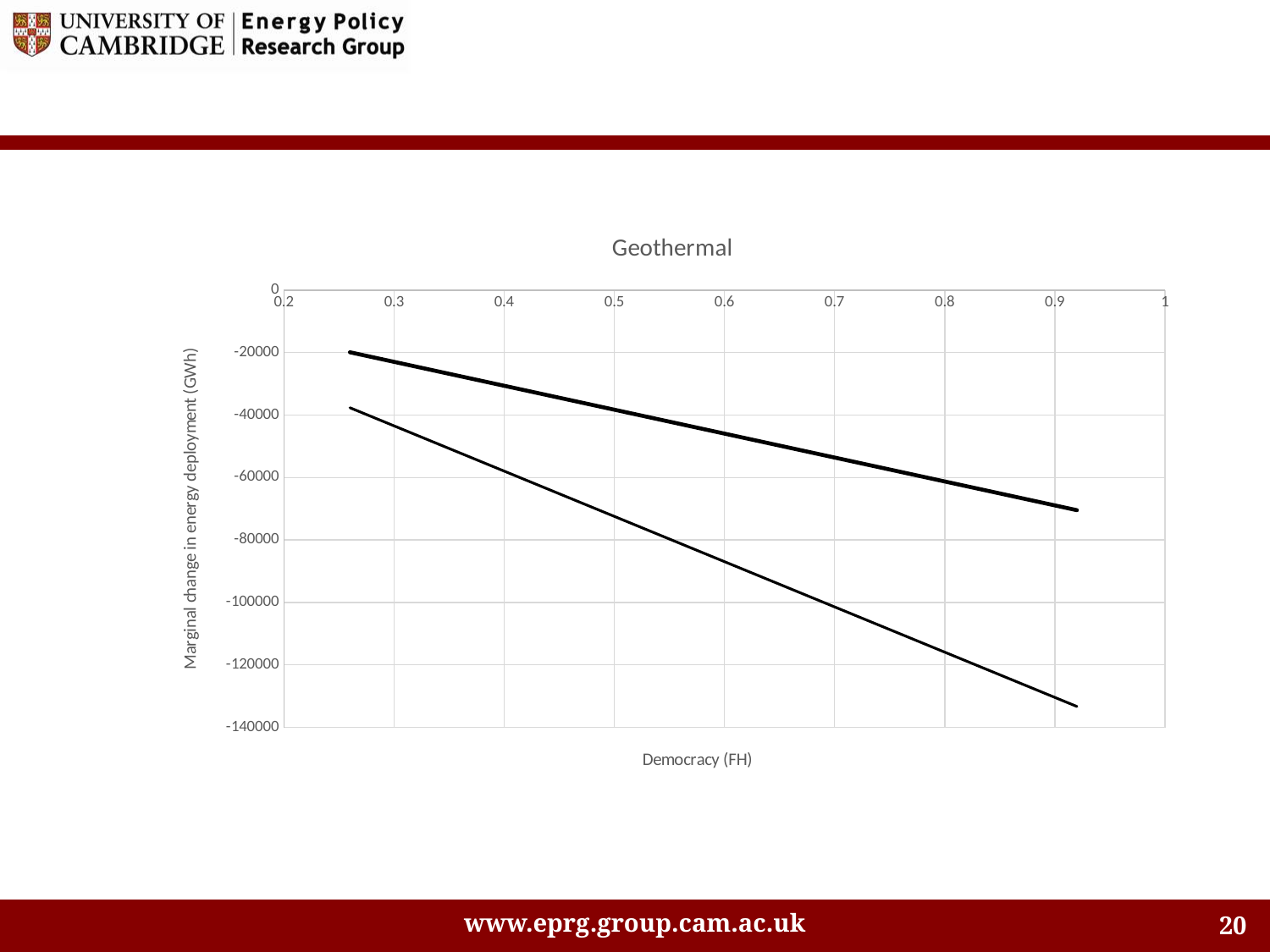
Is the value of the thin (lower) line at Democracy (FH) = 0.9 greater or less than -120000? less Is the value of the thin (lower) line at Democracy (FH) = 0.5 greater or less than -60000? less Is the value of the thin (lower) line at Democracy (FH) = 0.7 greater or less than -80000? less Do the plotted lines rise or fall as Democracy (FH) increases? Fall What kind of chart is shown on the slide? Line chart How many lines are plotted on the chart? 2 What is the title of the chart? Geothermal At Democracy (FH) = 0.9, which line has the lower value, the thick line or the thin line? The thin line What is the label of the x axis? Democracy (FH)